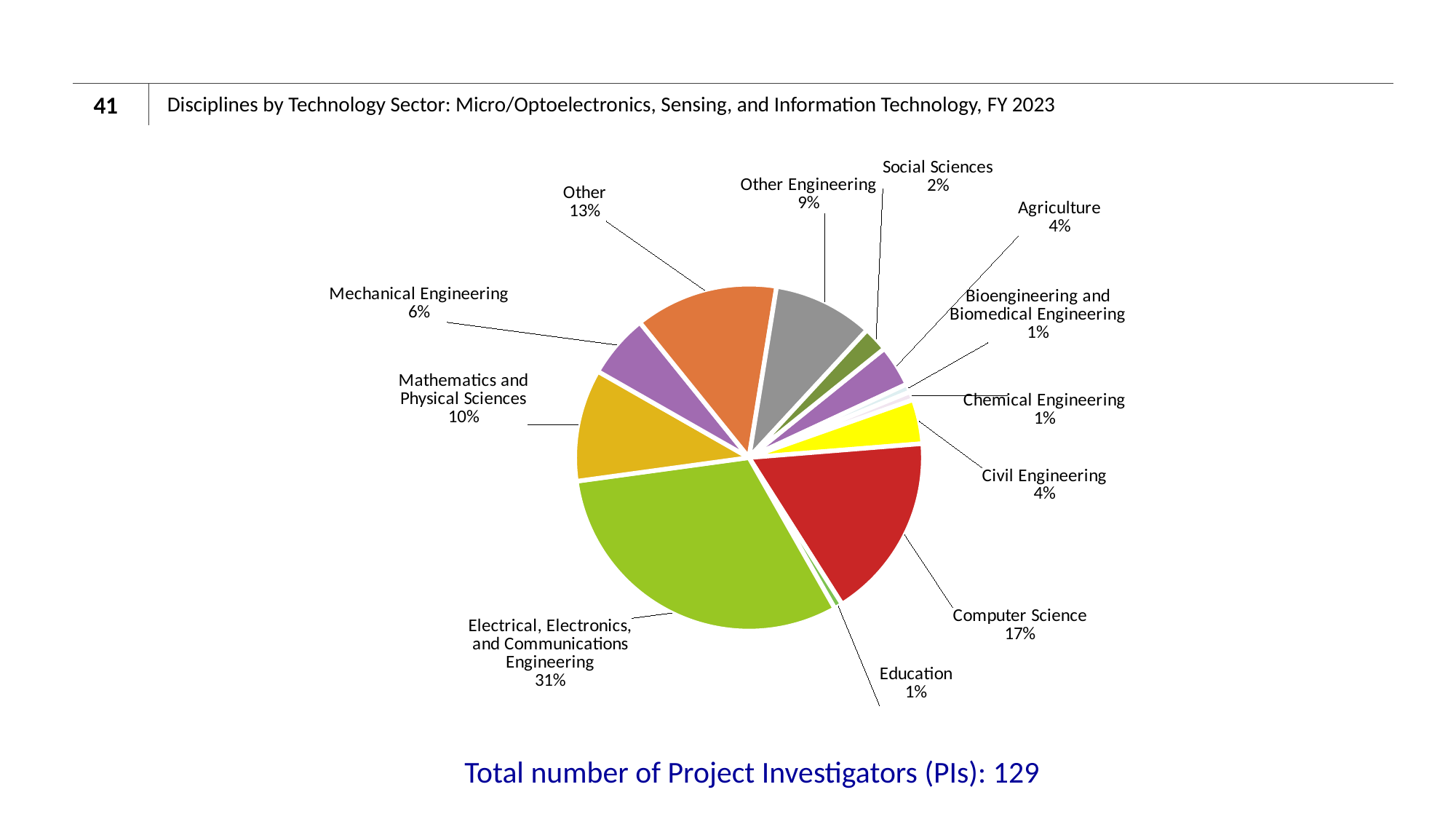
What percentage is shown for Other Engineering? 9% What is the difference in percentage points between Electrical, Electronics, and Communications Engineering and Computer Science? 14 Which discipline has the largest slice of the pie? Electrical, Electronics, and Communications Engineering What percentage is shown for Mathematics and Physical Sciences? 10% Which is larger, the share for Other or the share for Mechanical Engineering? Other How many slices does the pie chart have? 12 What is the title of the slide? Disciplines by Technology Sector: Micro/Optoelectronics, Sensing, and Information Technology, FY 2023 What is the total number of Project Investigators stated on the slide? 129 What percentage is shown for Social Sciences? 2% What kind of chart is shown on the slide? pie chart What is the difference in percentage points between Agriculture and Civil Engineering? 0 What share of the pie does Computer Science hold? 17%